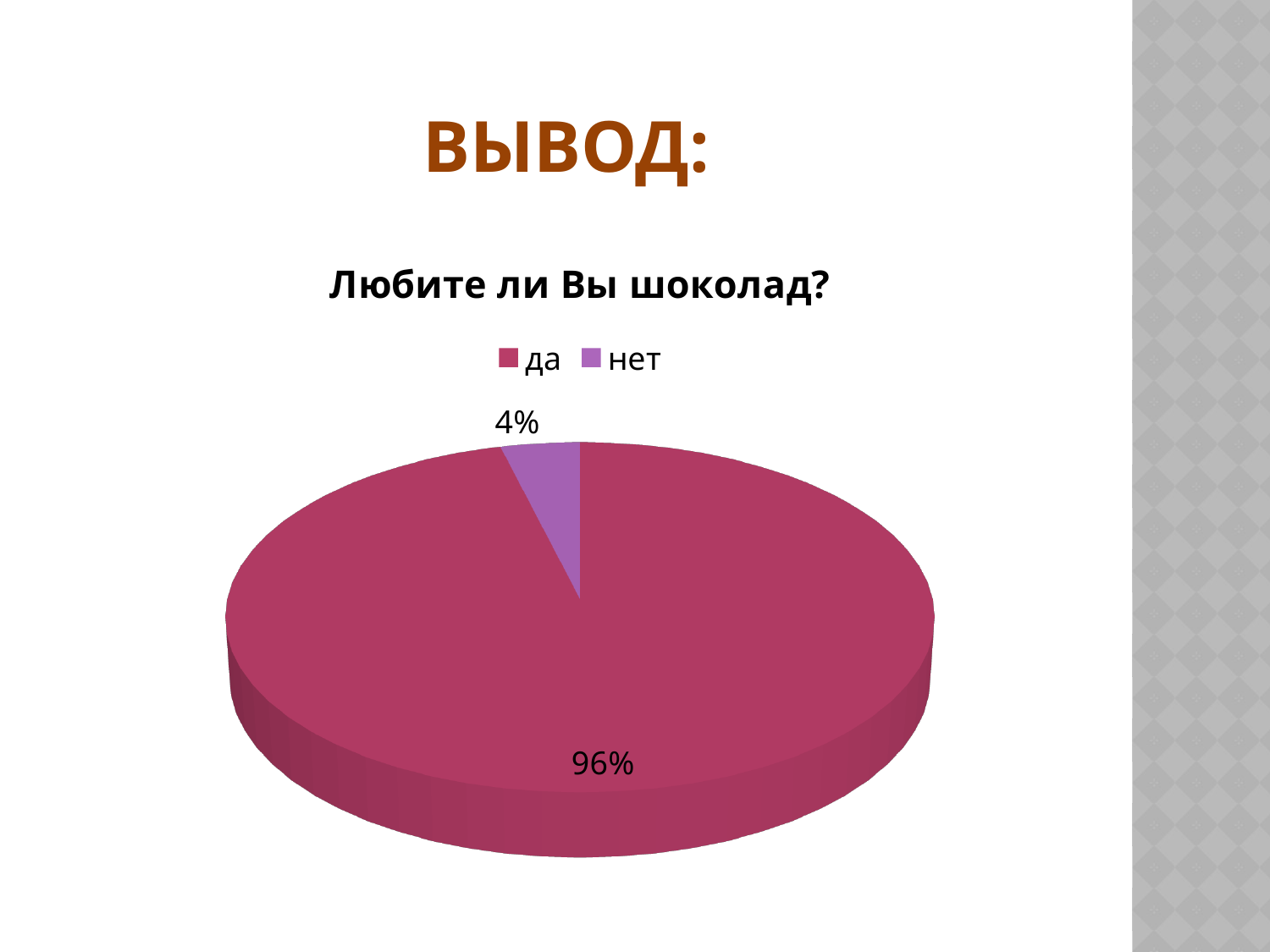
How many entries does the legend list? 2 Which is larger, the "да" slice or the "нет" slice? да Which slice is the largest? да What share of the pie does "да" take? 96% How many slices does the pie chart have? 2 What share of the pie does "нет" take? 4% What is the title of the chart? Любите ли Вы шоколад? What kind of chart is shown on the slide? pie chart What is the difference in percentage points between the "да" and "нет" slices? 92 Which slice is the smallest? нет What colour is the "нет" slice? purple